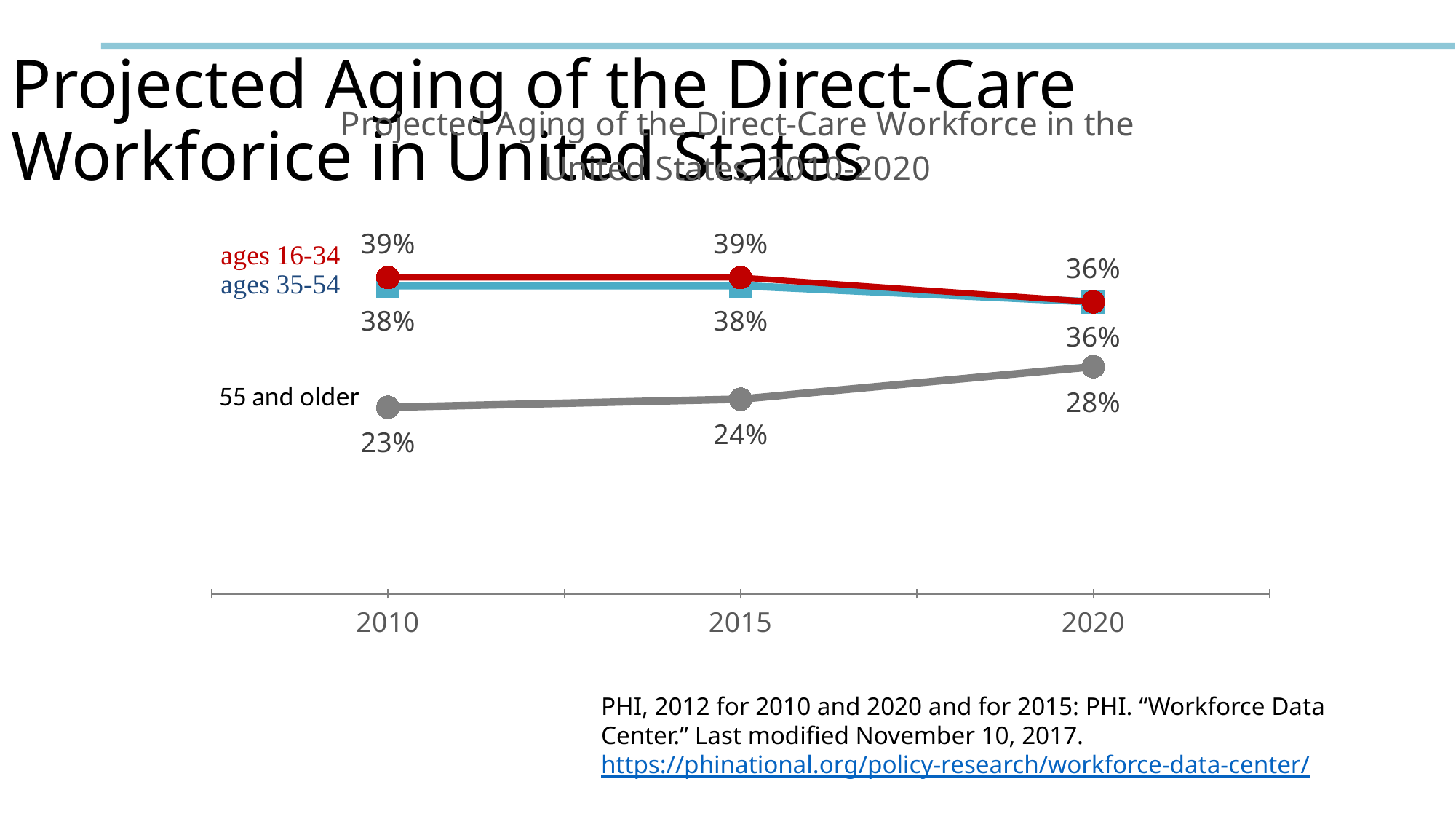
What type of chart is shown on the slide? line chart What is the value for 55 and older in 2020? 28% Does the value for 55 and older rise or fall from 2010 to 2020? rise What is the value for ages 35-54 in 2015? 39% In which year is the value for 55 and older the lowest? 2010 What is the value for 55 and older in 2010? 23% How many years are shown on the x axis? 3 What is the difference between the 55 and older values in 2020 and 2010? 5% What is the value for ages 16-34 in 2020? 36% Which is larger in 2015: the value for ages 16-34 or the value for 55 and older? ages 16-34 In which year is the value for 55 and older the highest? 2020 What is the value for ages 16-34 in 2010? 38%